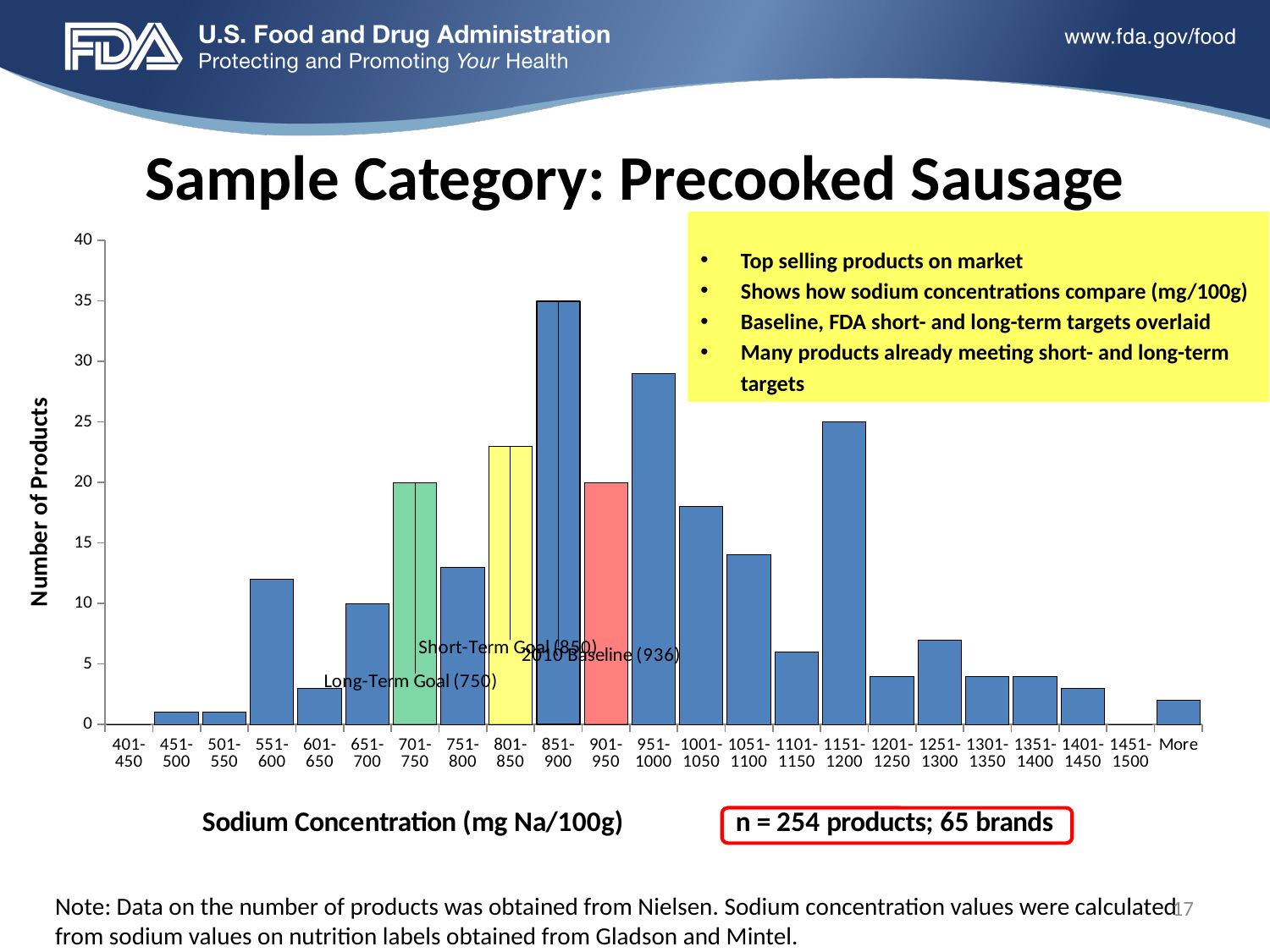
What type of chart is shown on the slide? bar chart How many products are in the 701-750 mg Na/100g range? 20 How many sodium concentration categories are shown on the x axis, including 'More'? 23 Is the number of products in the 1101-1150 range greater or less than 10? less Is the number of products in the 951-1000 range greater or less than 25? greater How many products are in the 851-900 mg Na/100g range? 35 How many products are in the 1151-1200 mg Na/100g range? 25 Which sodium concentration range has the highest number of products? 851-900 What is the title of the y axis? Number of Products How many products are in the 651-700 mg Na/100g range? 10 What is the difference in number of products between the 851-900 range and the 1151-1200 range? 10 Which range has more products, 551-600 or 601-650? 551-600